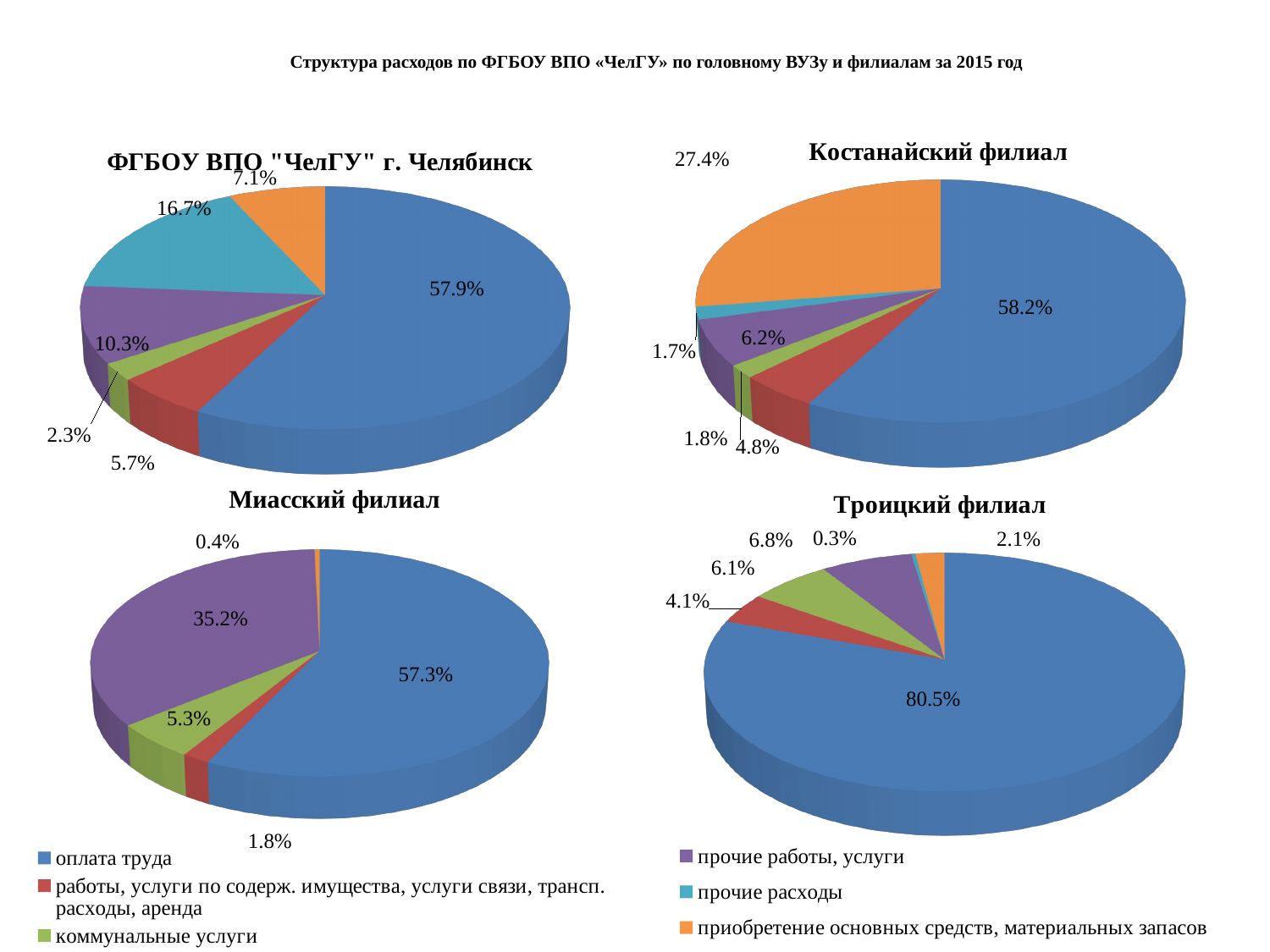
In the pie chart titled ФГБОУ ВПО "ЧелГУ" г. Челябинск, which category has the largest slice? оплата труда How many categories does the legend list? 6 In the pie chart titled Троицкий филиал, which category has the smallest slice? прочие расходы In the pie chart titled Костанайский филиал, what is the difference between the оплата труда slice and the приобретение основных средств, материальных запасов slice? 30.8% In the pie chart titled Троицкий филиал, what share is labelled for оплата труда (the blue slice)? 80.5% In the pie chart titled Миасский филиал, what share is labelled for коммунальные услуги (the green slice)? 5.3% In the pie chart titled ФГБОУ ВПО "ЧелГУ" г. Челябинск, which is larger: the прочие расходы slice or the прочие работы, услуги slice? прочие расходы In the pie chart titled Миасский филиал, what share is labelled for прочие работы, услуги (the purple slice)? 35.2% What type of chart is used for Троицкий филиал? pie chart How many pie charts are shown on the slide? 4 In the pie chart titled Костанайский филиал, what share is labelled for приобретение основных средств, материальных запасов (the orange slice)? 27.4% In the pie chart titled ФГБОУ ВПО "ЧелГУ" г. Челябинск, what share is labelled for оплата труда (the blue slice)? 57.9%